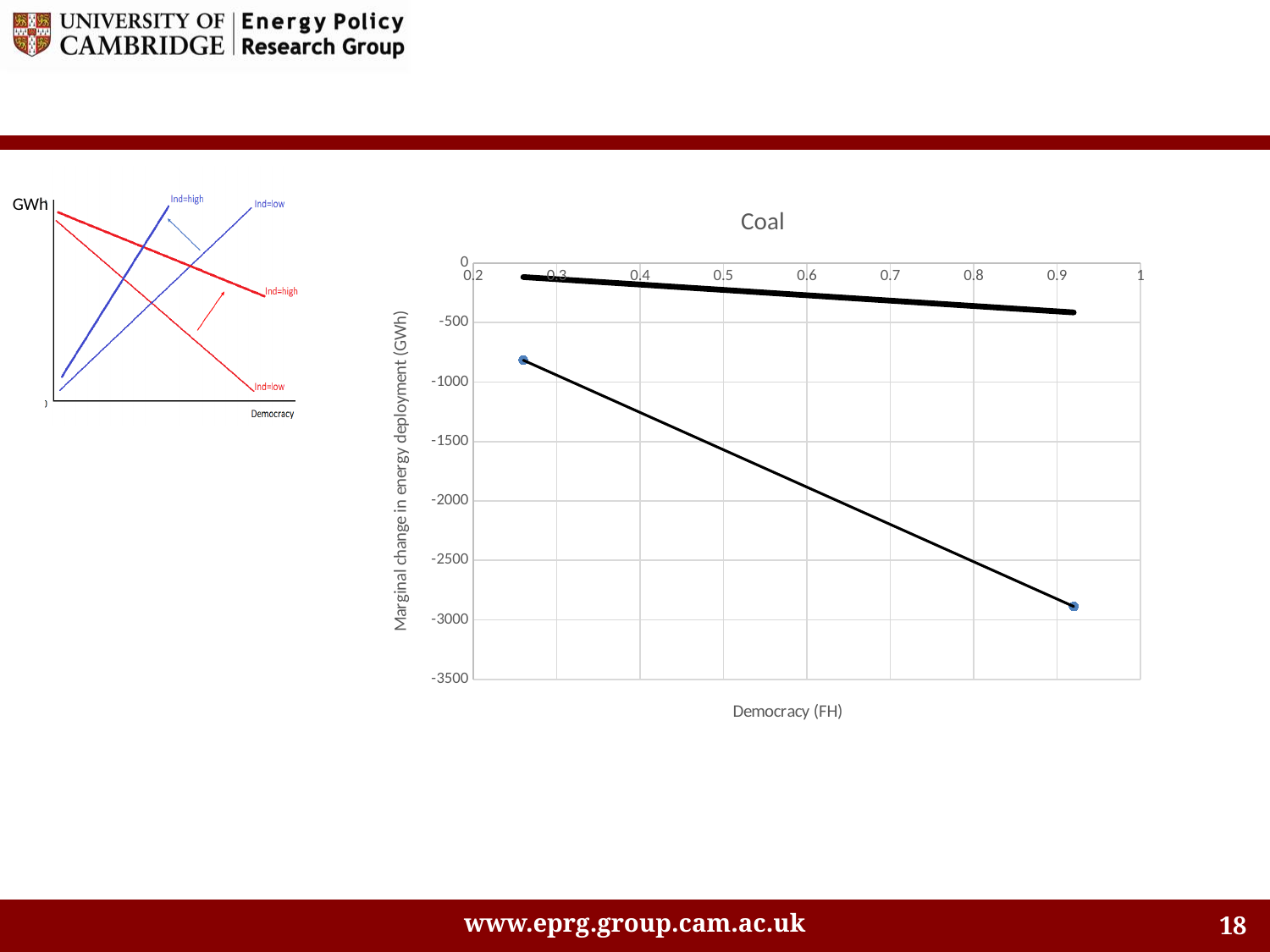
In the "Coal" chart, what is the label of the y axis? Marginal change in energy deployment (GWh) What is the title of the chart on the right of the slide? Coal In the "Coal" chart, which line has the lower value near Democracy 0.9, the thick upper line or the thin lower line? the thin lower line In the "Coal" chart, is the value of the thin lower line at its left-hand end (near Democracy 0.3) greater or less than -1000? greater In the "Coal" chart, is the value of the thin lower line at its right-hand end (near Democracy 0.9) greater or less than -2500? less In the "Coal" chart, how many lines are plotted? 2 In the "Coal" chart, do the values of the thin lower line rise or fall as Democracy (FH) increases? fall In the "Coal" chart, what is the lowest value shown on the y axis? -3500 What kind of chart is the chart titled "Coal"? line chart In the "Coal" chart, is the value of the thick upper line at its right-hand end (near Democracy 0.9) greater or less than -500? greater In the "Coal" chart, do the values of the thick upper line rise or fall as Democracy (FH) increases? fall